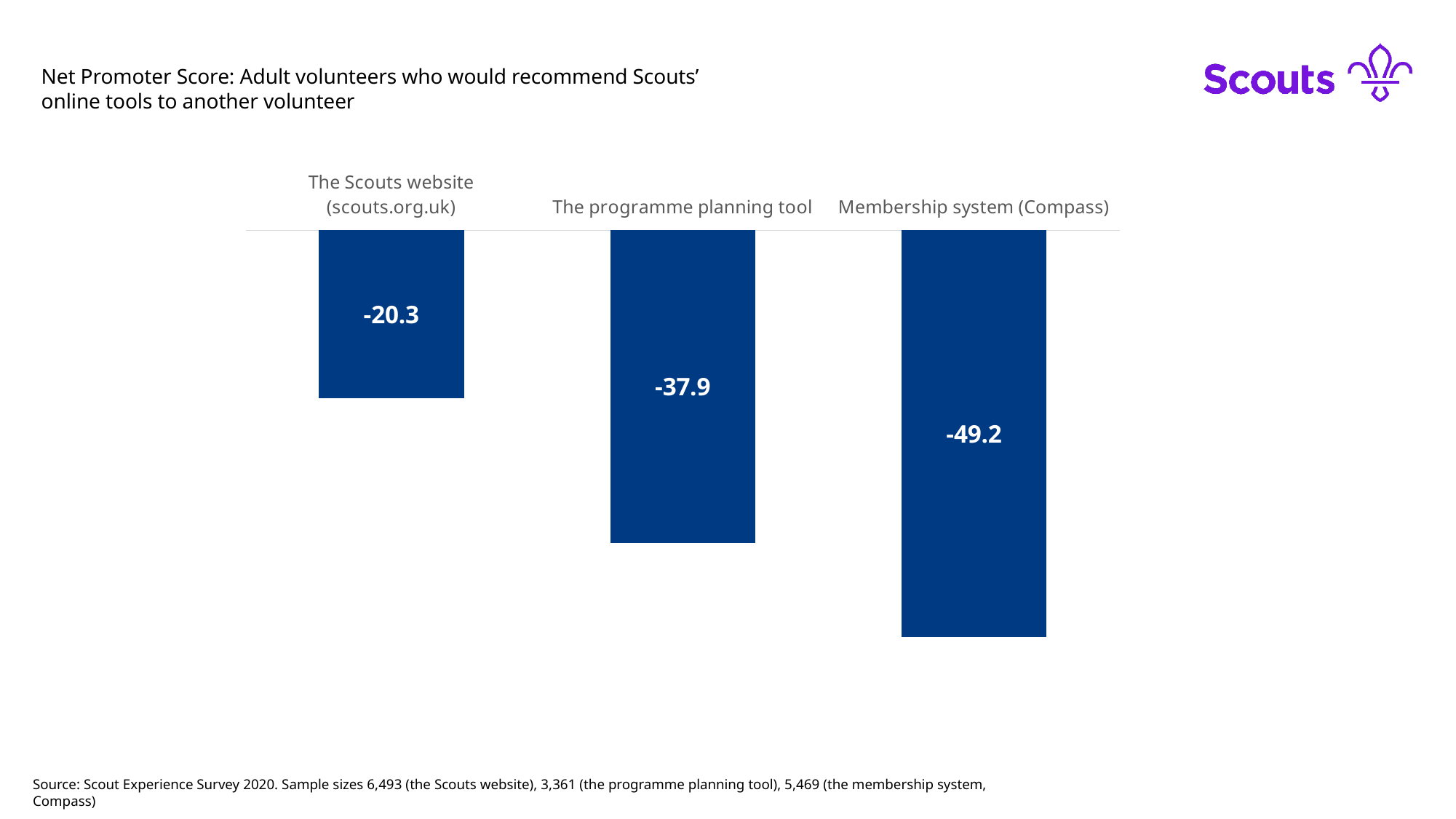
Which online tool has the lowest Net Promoter Score? Membership system (Compass) Which has a higher Net Promoter Score, The programme planning tool or Membership system (Compass)? The programme planning tool What is the Net Promoter Score for Membership system (Compass)? -49.2 What is the Net Promoter Score for The Scouts website (scouts.org.uk)? -20.3 How many online tools are shown in the chart? 3 What is the Net Promoter Score for The programme planning tool? -37.9 Do the Net Promoter Scores rise or fall from left to right across the chart? Fall What is the difference between the Net Promoter Scores of The programme planning tool and Membership system (Compass)? 11.3 What kind of chart is shown on the slide? Bar chart What is the difference between the Net Promoter Scores of The Scouts website (scouts.org.uk) and Membership system (Compass)? 28.9 Which online tool has the highest Net Promoter Score? The Scouts website (scouts.org.uk) Which survey is cited as the source of the chart data? Scout Experience Survey 2020